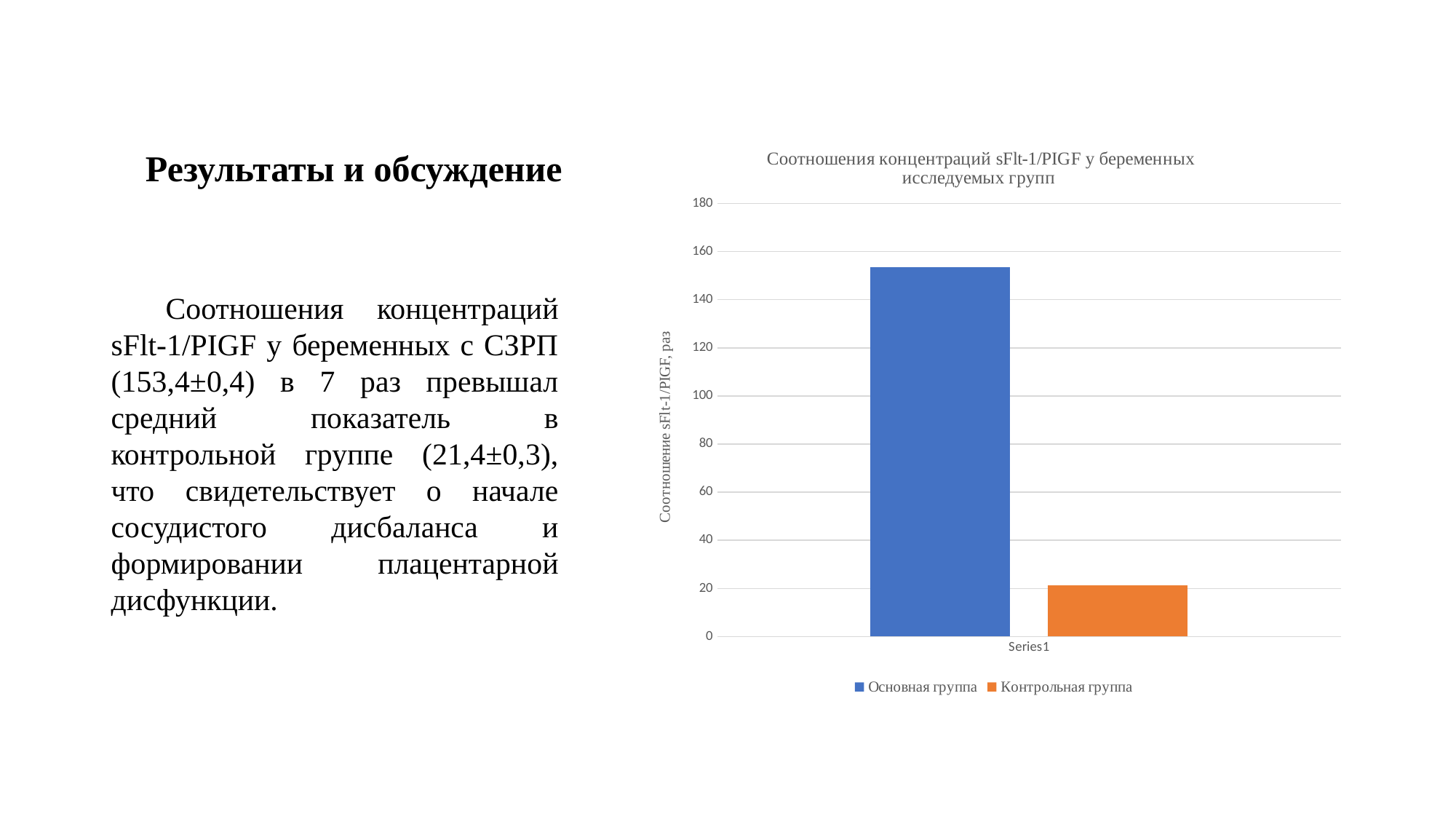
What is the title of the chart? Соотношения концентраций sFlt-1/PIGF у беременных исследуемых групп What is the label on the vertical axis of the chart? Соотношение sFlt-1/PIGF, раз What colour is the bar for Контрольная группа? orange Is the value for Основная группа greater or less than 160? less Which series has the highest bar in the chart? Основная группа How many series does the chart legend list? 2 Which series has the lowest bar in the chart? Контрольная группа Is the value for Контрольная группа greater or less than 40? less Is the value for Основная группа greater or less than 140? greater Which series has the higher bar, Основная группа or Контрольная группа? Основная группа What kind of chart is shown on the slide? bar chart